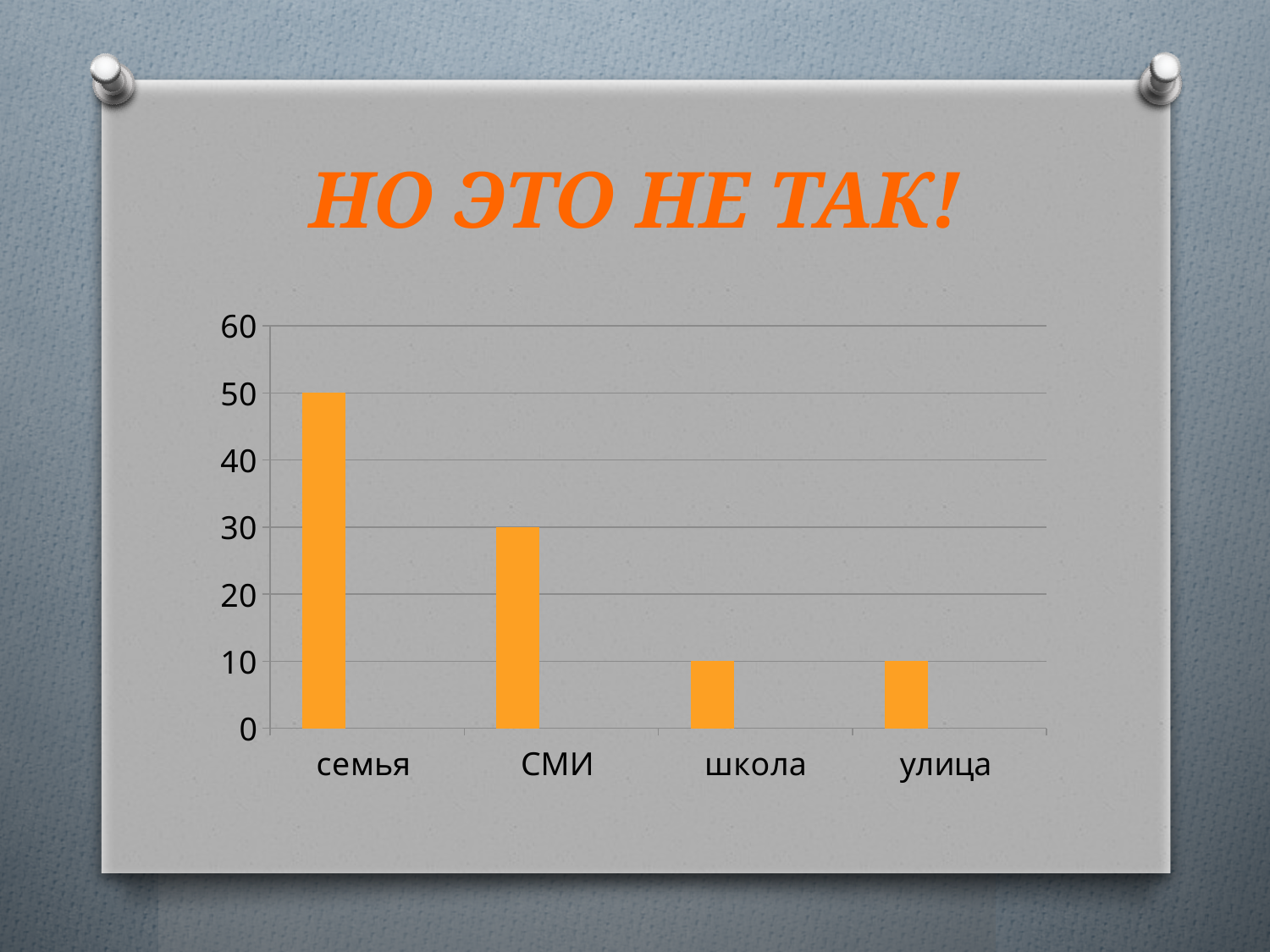
Is the value for семья greater or less than 40? greater Which category has the highest value? семья Which is larger, the value for СМИ or the value for школа? СМИ What is the value for семья? 50 What is the value for СМИ? 30 What is the value for улица? 10 How many categories are shown on the x axis of the chart? 4 What is the difference between the values for семья and СМИ? 20 What is the value for школа? 10 Do the values generally rise or fall from left to right along the x axis? fall What type of chart is shown on the slide? bar chart What colour are the bars in the chart? orange